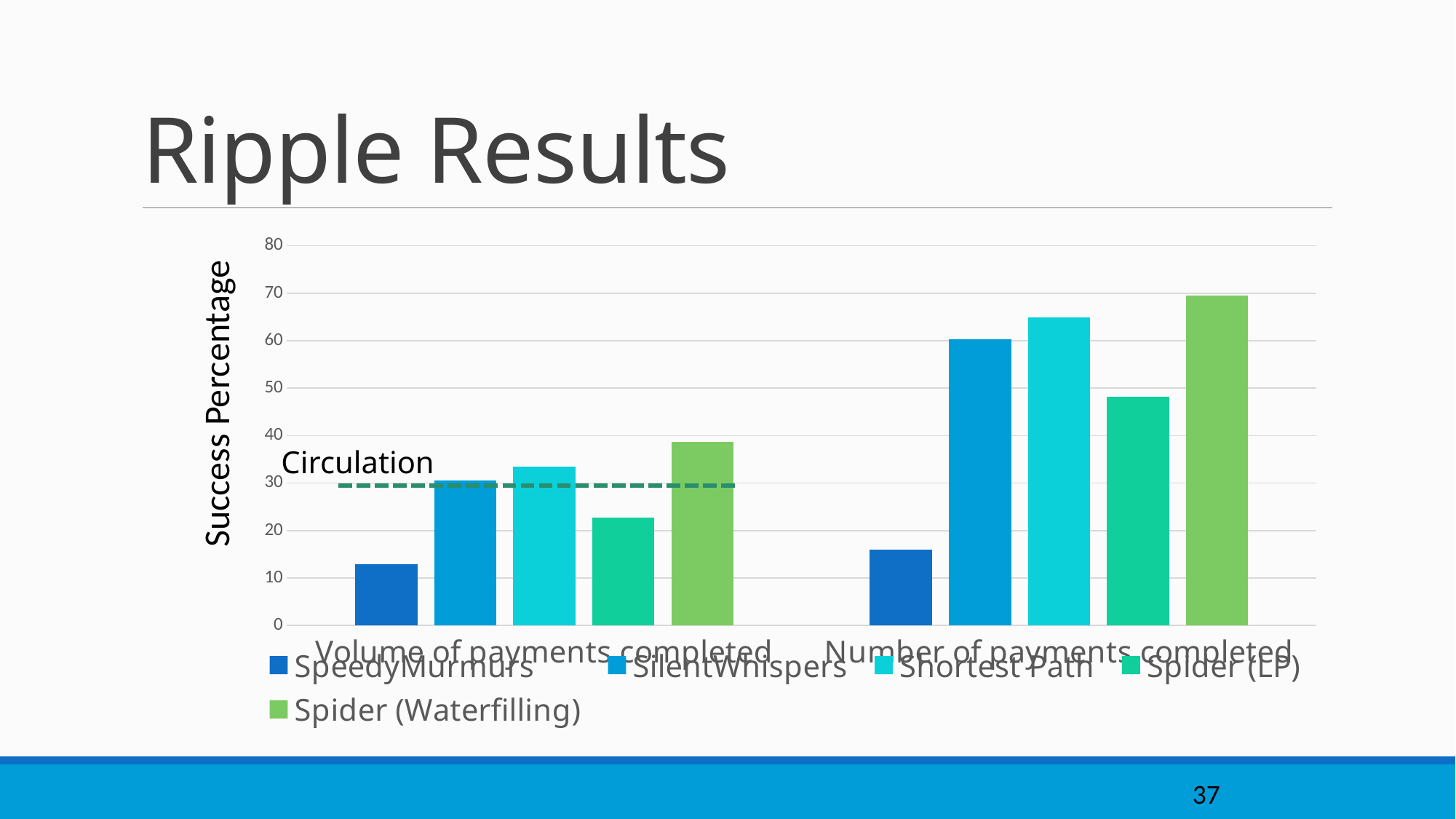
Which series has the lowest value for Volume of payments completed? SpeedyMurmurs Which series has the highest value for Volume of payments completed? Spider (Waterfilling) For Number of payments completed, which is larger: Shortest Path or Spider (LP)? Shortest Path Is the value for SpeedyMurmurs under Volume of payments completed greater or less than 20? less How many categories are shown on the x axis? 2 What kind of chart is shown on the slide? Bar chart Which series has the highest value for Number of payments completed? Spider (Waterfilling) What label is attached to the dashed horizontal line on the chart? Circulation What is the label of the y axis? Success Percentage How many series does the legend list? 5 Which series has the lowest value for Number of payments completed? SpeedyMurmurs Is the value for Spider (Waterfilling) under Number of payments completed greater or less than 60? greater